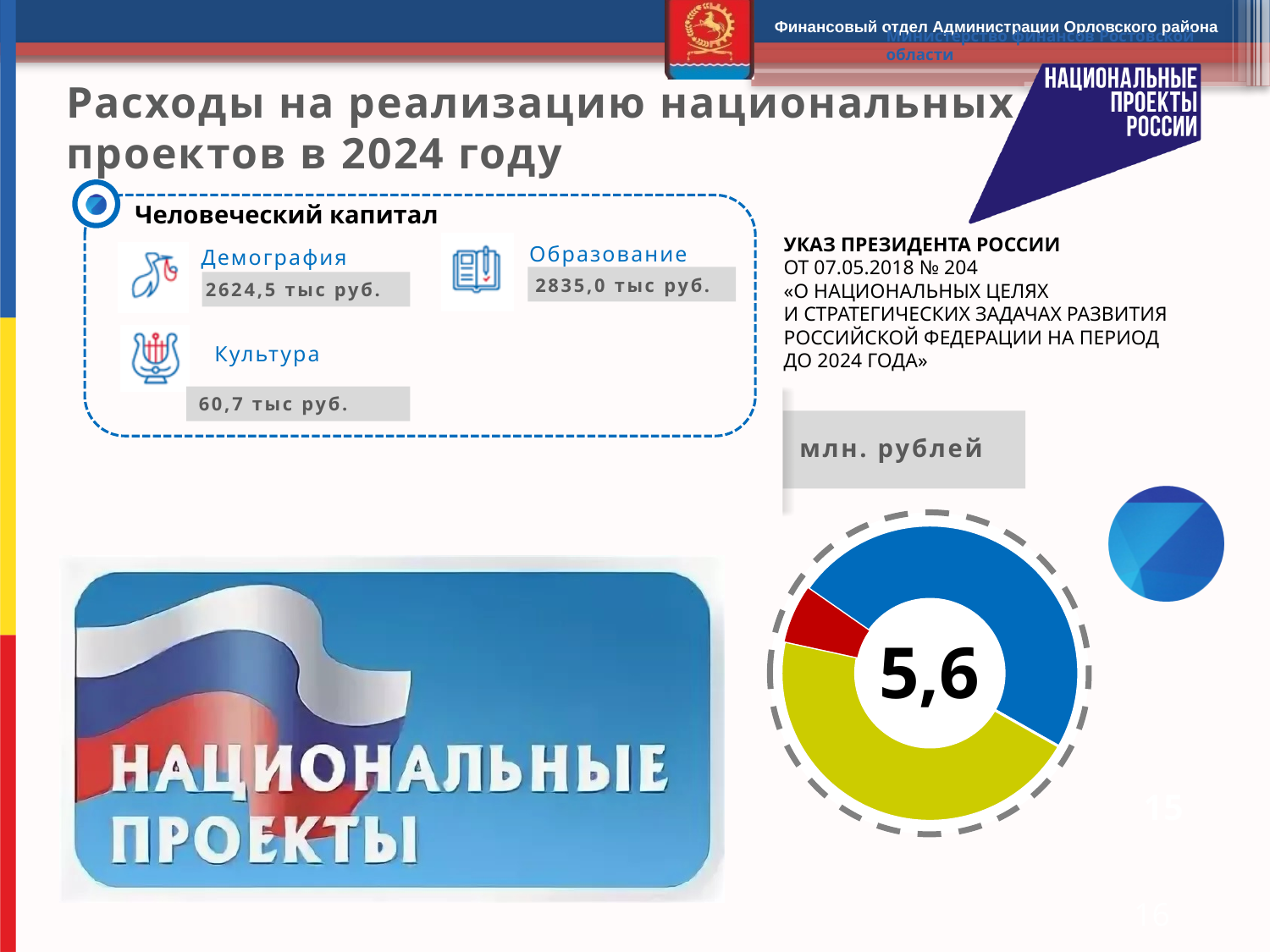
What value is printed in the centre of the donut chart? 5,6 How many slices does the donut chart have? 3 What unit is shown in the label above the donut chart? млн. рублей Which is larger in the donut chart, the red slice or the yellow slice? The yellow slice What kind of chart is shown on the slide? Pie (donut) chart Which is larger in the donut chart, the red slice or the blue slice? The blue slice Does the donut chart have a legend? No Which colour slice of the donut chart is the smallest? Red